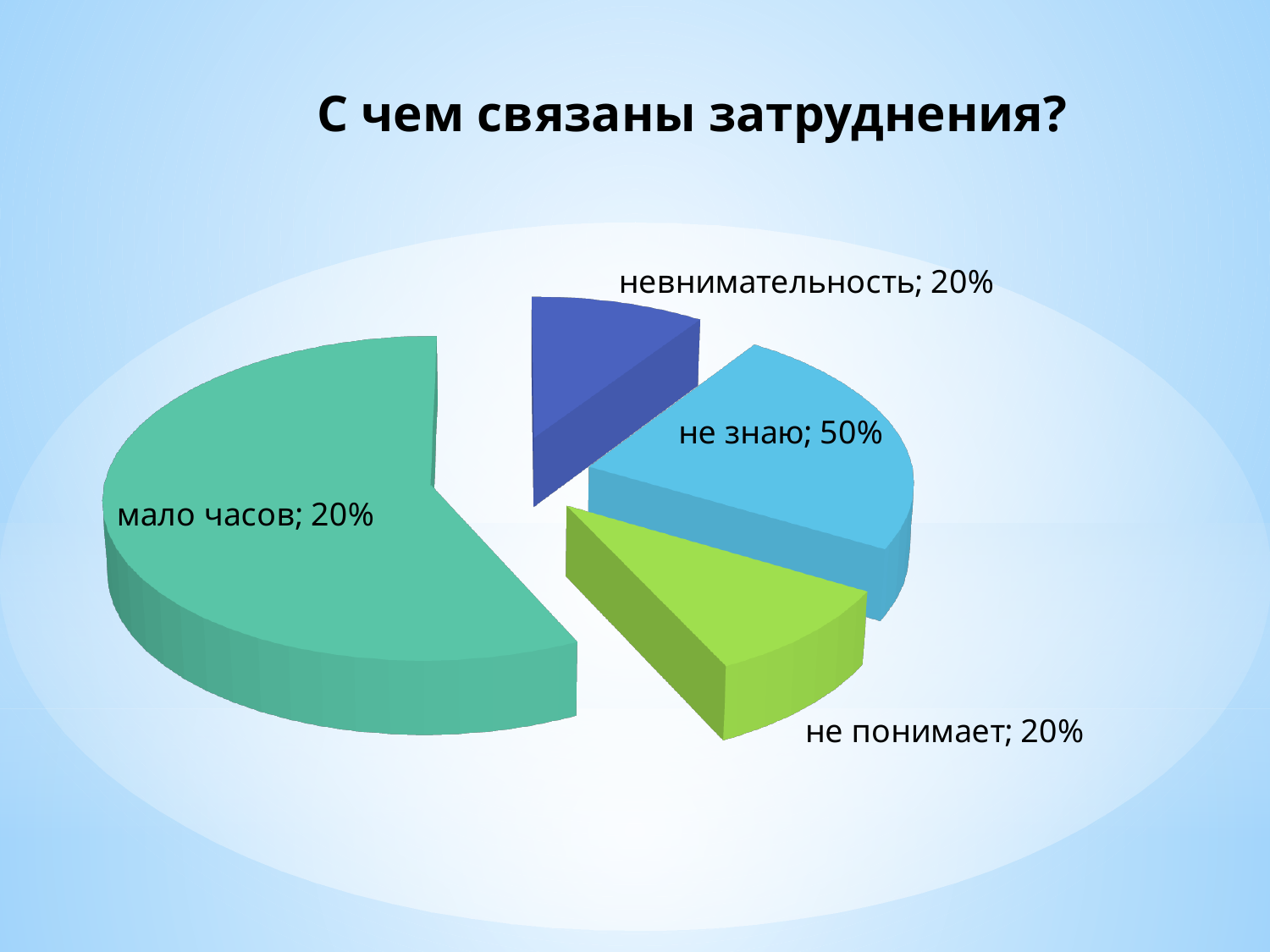
Which category is labelled on the dark blue slice? невнимательность What is the value shown for "мало часов"? 20% What is the value shown for "невнимательность"? 20% How many slices does the pie chart have? 4 What is the value shown for "не знаю"? 50% What is the title of the chart? С чем связаны затруднения? What is the value shown for "не понимает"? 20% What kind of chart is shown on the slide? pie chart